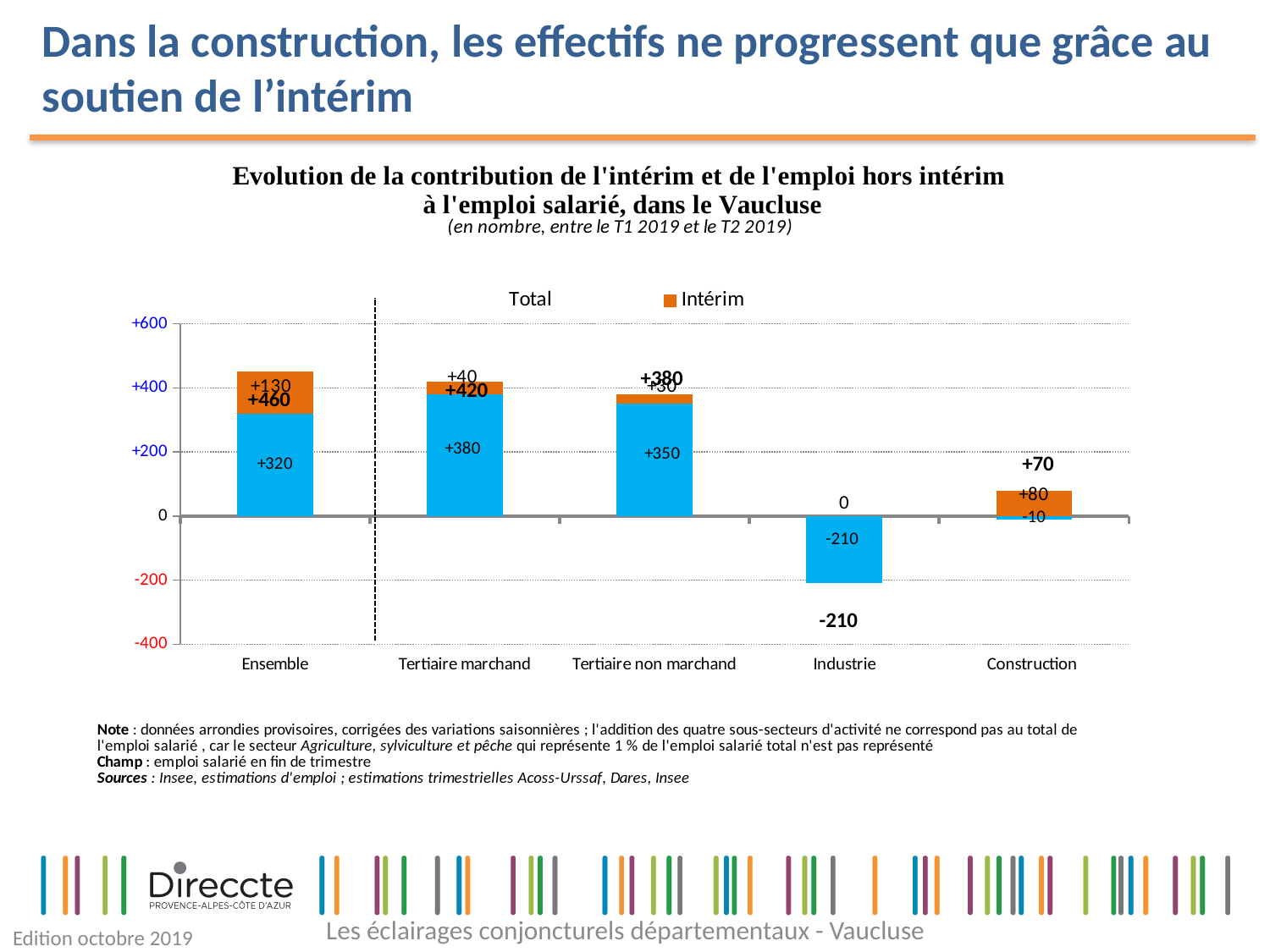
What is the difference between the Intérim values for Construction and Tertiaire non marchand? 50 Which category has the lowest total? Industrie What is the total shown for Construction? +70 What is the Intérim value for Ensemble? +130 What kind of chart is this? Stacked bar chart What is the Intérim value for Construction? +80 Which is larger, the blue segment for Tertiaire marchand or for Tertiaire non marchand? Tertiaire marchand What is the total shown for Tertiaire marchand? +420 What is the Intérim value for Industrie? 0 How many categories are shown on the x axis? 5 What is the value of the blue segment for Industrie? -210 Which category has the highest total? Ensemble